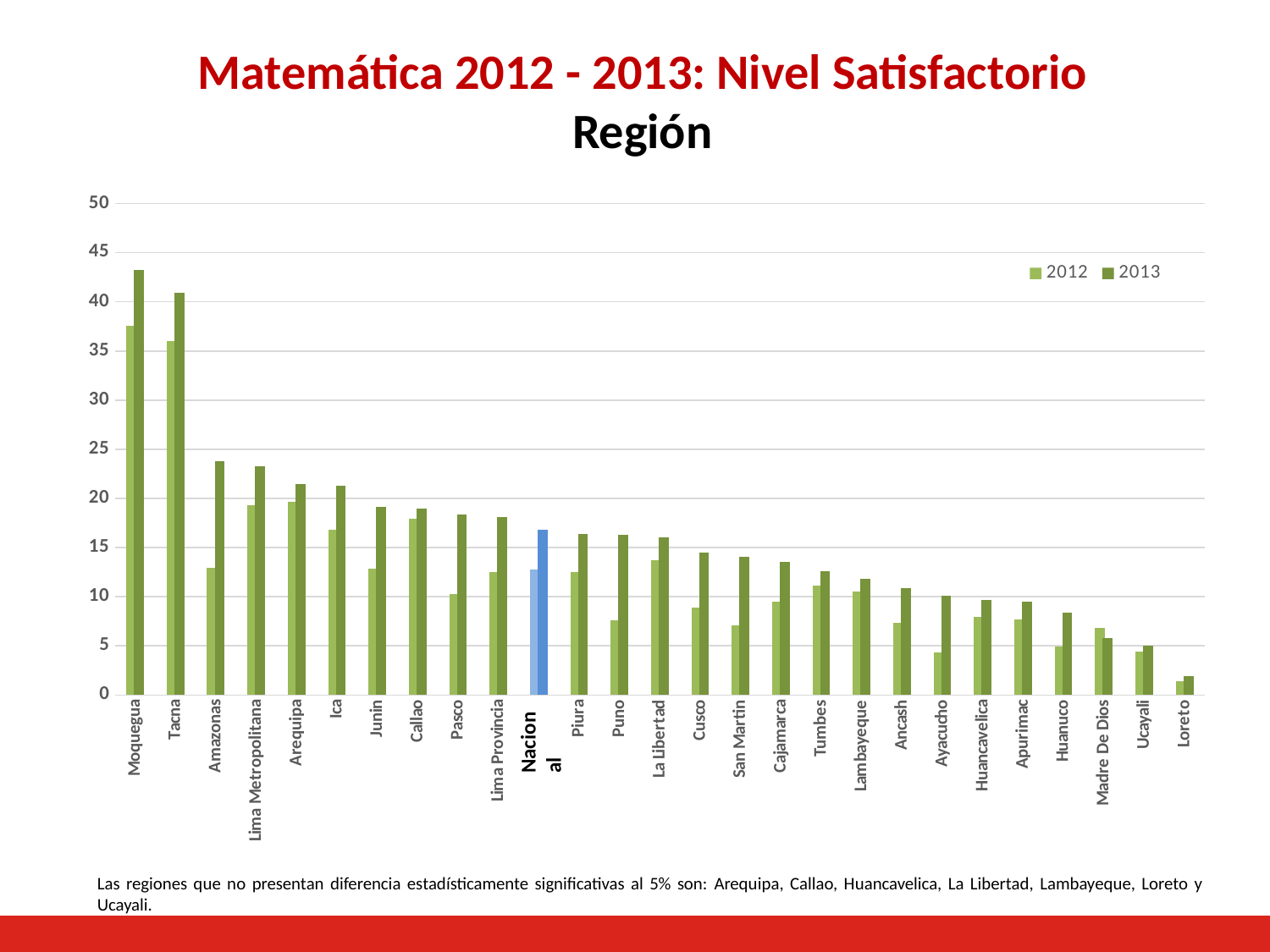
Is the 2013 value for Loreto greater or less than 5? less Do the 2013 values generally rise or fall moving from left to right along the x axis? fall Is the 2013 value for Nacional greater or less than 15? greater Which region has the lowest 2013 value? Loreto How many series does the legend list? 2 How many regions (categories) are shown along the x axis, including Nacional? 27 Which category's bars are coloured blue instead of green? Nacional Is the 2013 value for Moquegua greater or less than 40? greater For Amazonas, which year has the larger value, 2012 or 2013? 2013 What kind of chart is shown on the slide? bar chart Which region has the highest 2013 value? Moquegua